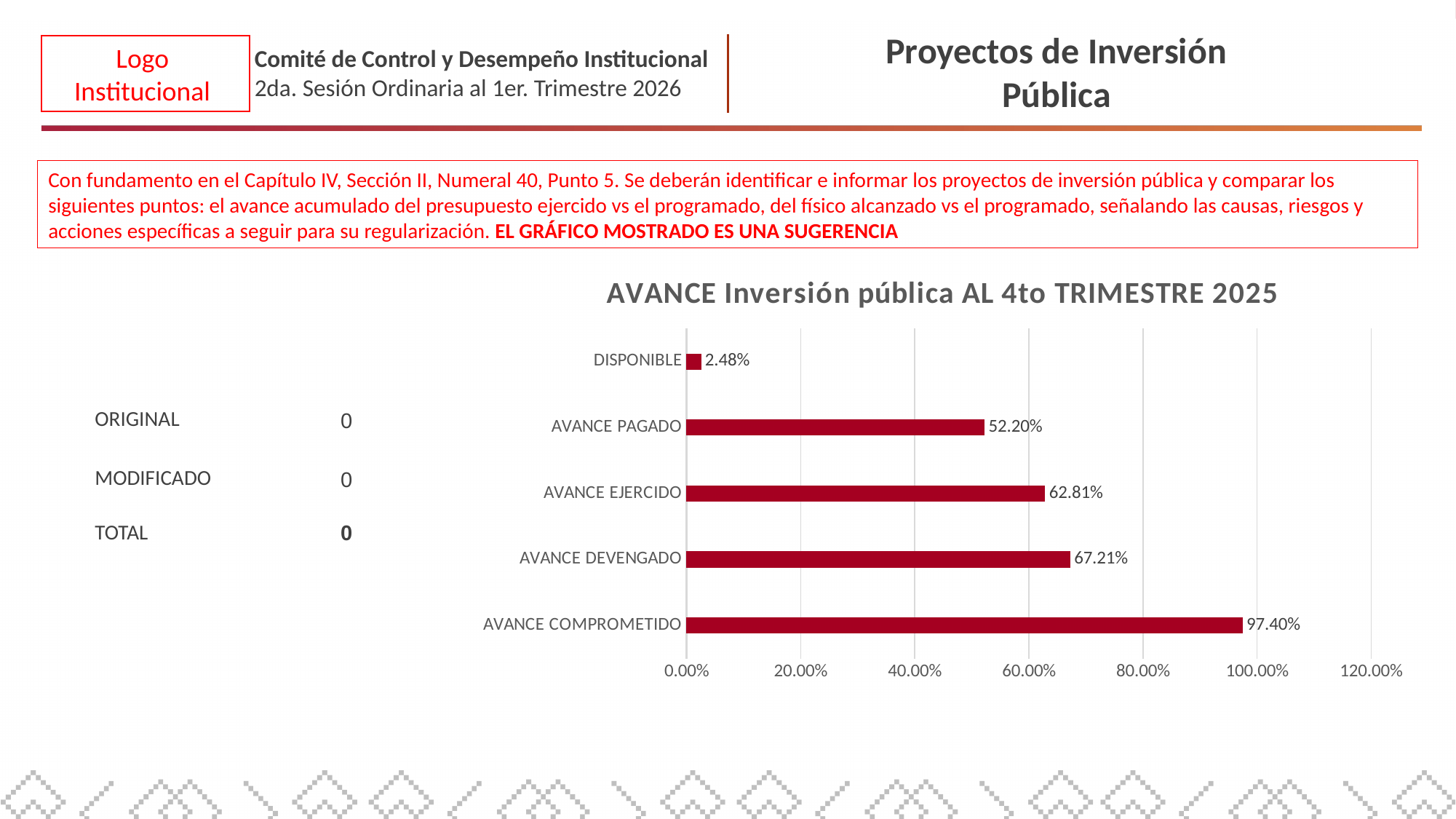
Which is larger, AVANCE DEVENGADO or AVANCE EJERCIDO? AVANCE DEVENGADO What is the value for AVANCE PAGADO? 52.20% What is the title of the chart? AVANCE Inversión pública AL 4to TRIMESTRE 2025 What is the value for AVANCE COMPROMETIDO? 97.40% What kind of chart is shown on the slide? Bar chart Which category has the lowest value? DISPONIBLE How many categories are shown in the chart? 5 What is the value for DISPONIBLE? 2.48% What is the difference between AVANCE COMPROMETIDO and AVANCE PAGADO? 45.20% What is the value for AVANCE DEVENGADO? 67.21% What is the value for AVANCE EJERCIDO? 62.81% Which category has the highest value? AVANCE COMPROMETIDO